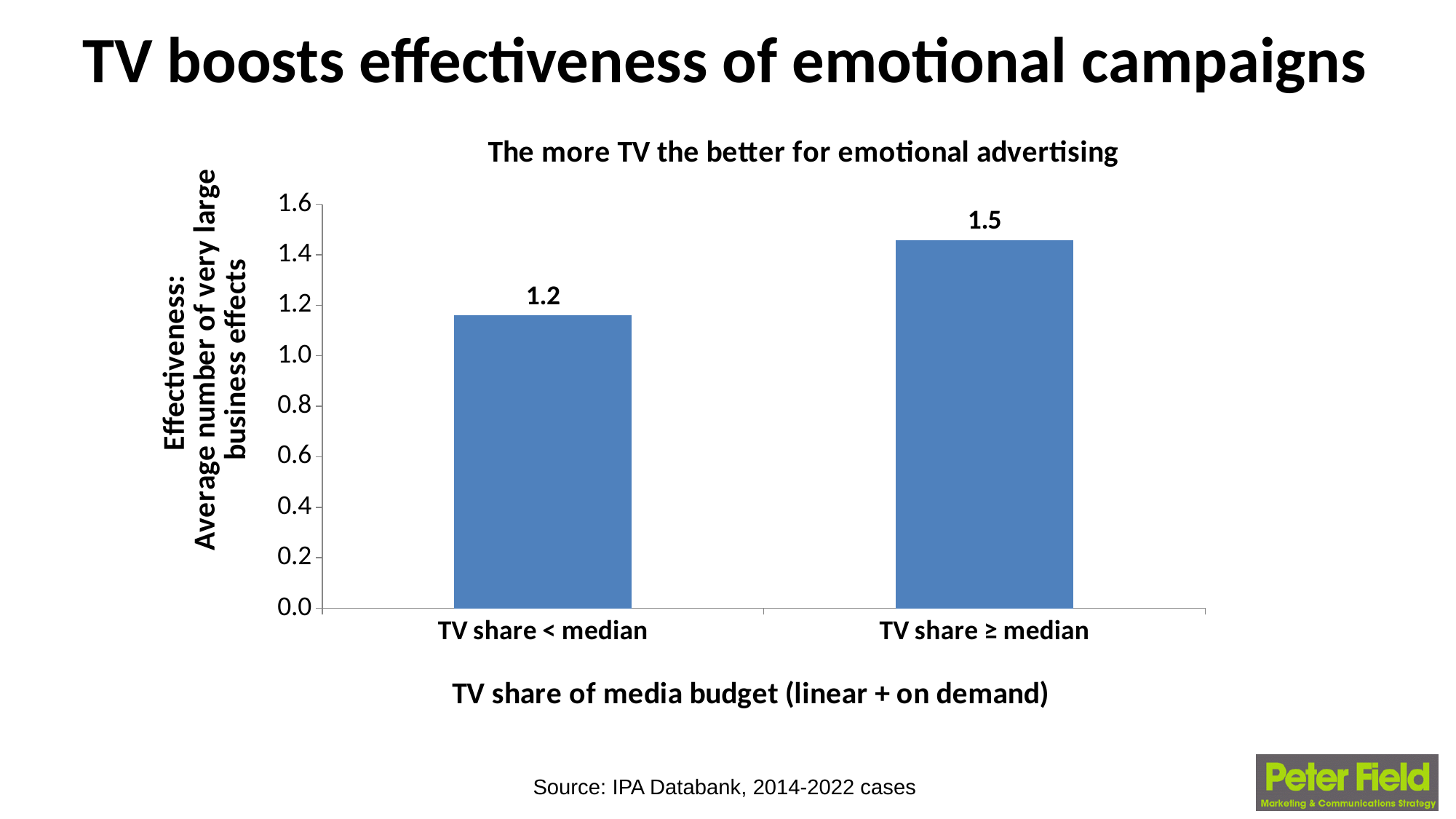
What kind of chart is shown? bar chart Is the value for TV share ≥ median greater or less than 1.4? greater Is the value for TV share < median greater or less than 1.0? greater How many categories are shown on the x axis? 2 Which category has the highest value? TV share ≥ median What is the x-axis title of the chart? TV share of media budget (linear + on demand) What is the value for TV share ≥ median? 1.5 What is the title of the chart? The more TV the better for emotional advertising Which category has the lowest value? TV share < median Which is larger, the value for TV share < median or TV share ≥ median? TV share ≥ median What is the difference between the values for TV share ≥ median and TV share < median? 0.3 What is the value for TV share < median? 1.2